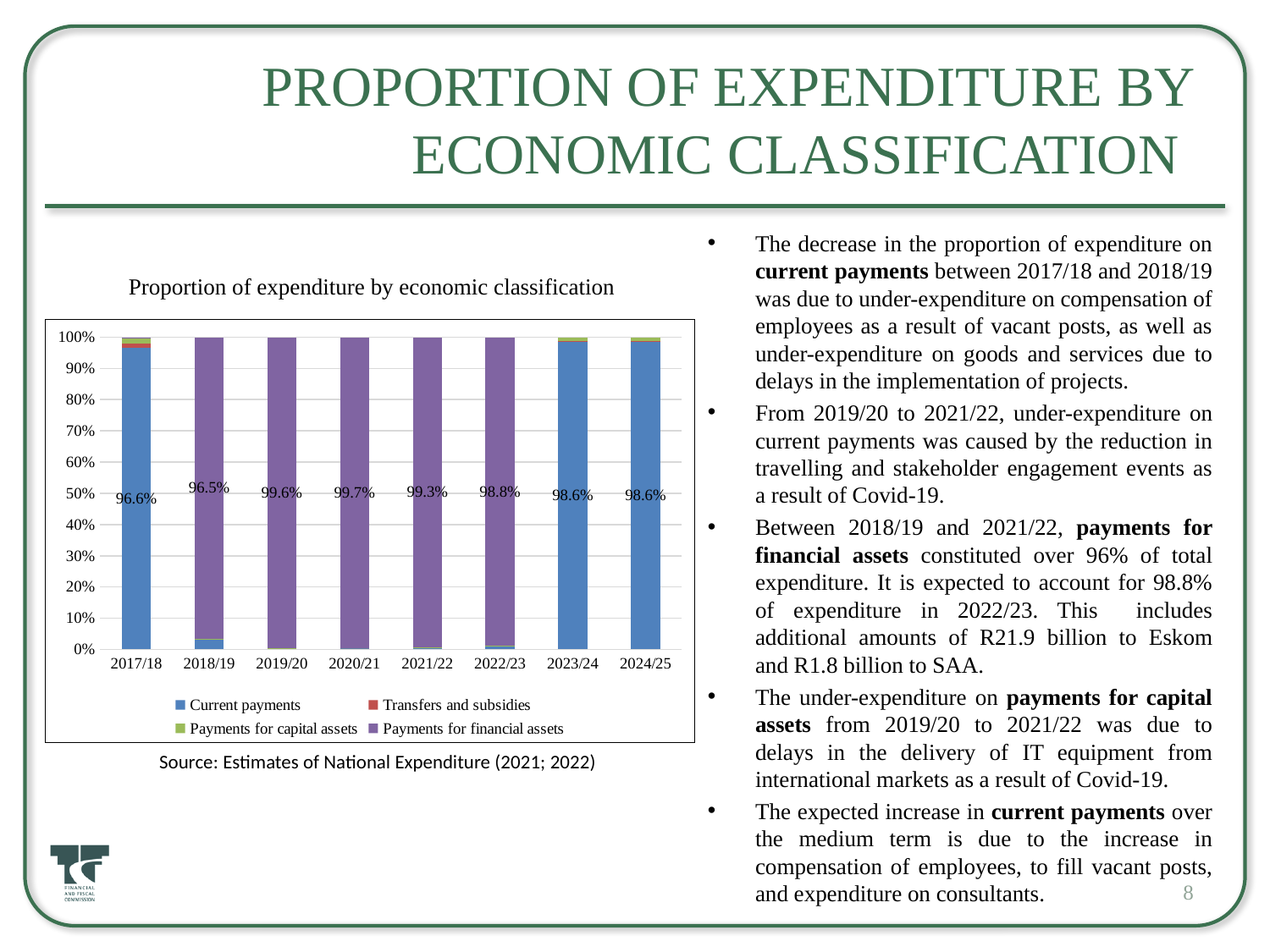
How many series does the chart legend list? 4 Which series is shown in purple in the chart legend? Payments for financial assets What is the data label shown on the 2020/21 bar? 99.7% Which year has the highest labelled value in the chart? 2020/21 Which is larger, the labelled value for 2019/20 or for 2021/22? 2019/20 What kind of chart is shown on the slide? Stacked bar chart What is the data label shown on the 2022/23 bar? 98.8% What is the difference between the labelled values for 2020/21 and 2018/19? 3.2 percentage points How many financial years are shown on the x axis of the chart? 8 Which year has the lowest labelled value in the chart? 2018/19 Is the share of Current payments in 2018/19 greater or less than 10%? less What is the data label shown on the 2017/18 bar? 96.6%